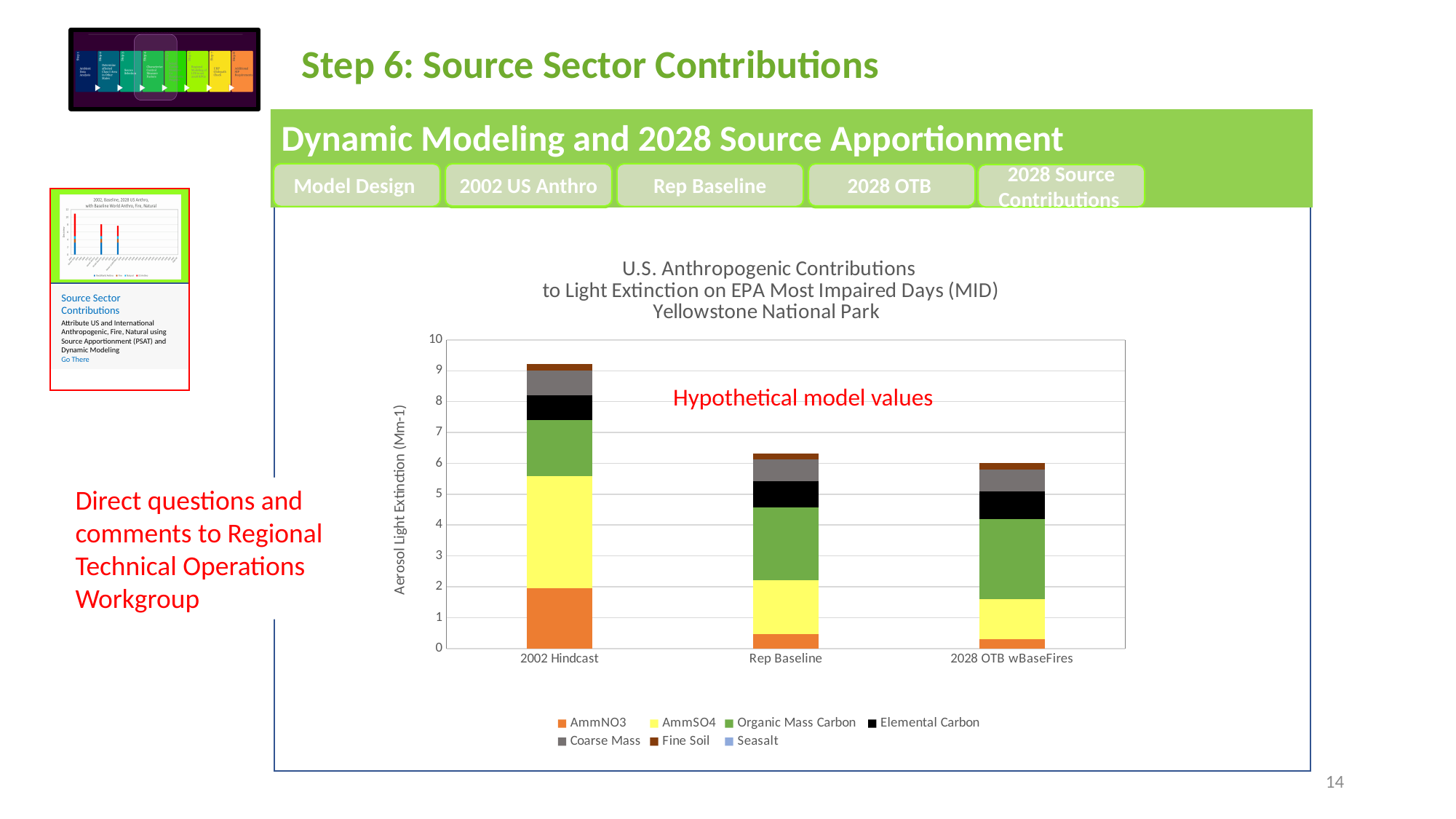
Is the total value for Rep Baseline greater or less than 7? less Do the total bar values rise or fall from 2002 Hindcast to 2028 OTB wBaseFires? fall Which category has the highest total aerosol light extinction? 2002 Hindcast Which national park is named in the chart title? Yellowstone National Park How many series does the chart's legend list? 7 Is the total value for 2002 Hindcast greater or less than 8? greater Is the AmmNO3 value for 2002 Hindcast greater or less than 1? greater How many categories are shown on the x axis of the chart? 3 What is the label on the chart's y axis? Aerosol Light Extinction (Mm-1) Which has a larger total bar, 2002 Hindcast or Rep Baseline? 2002 Hindcast What kind of chart is shown on the slide? Stacked bar chart